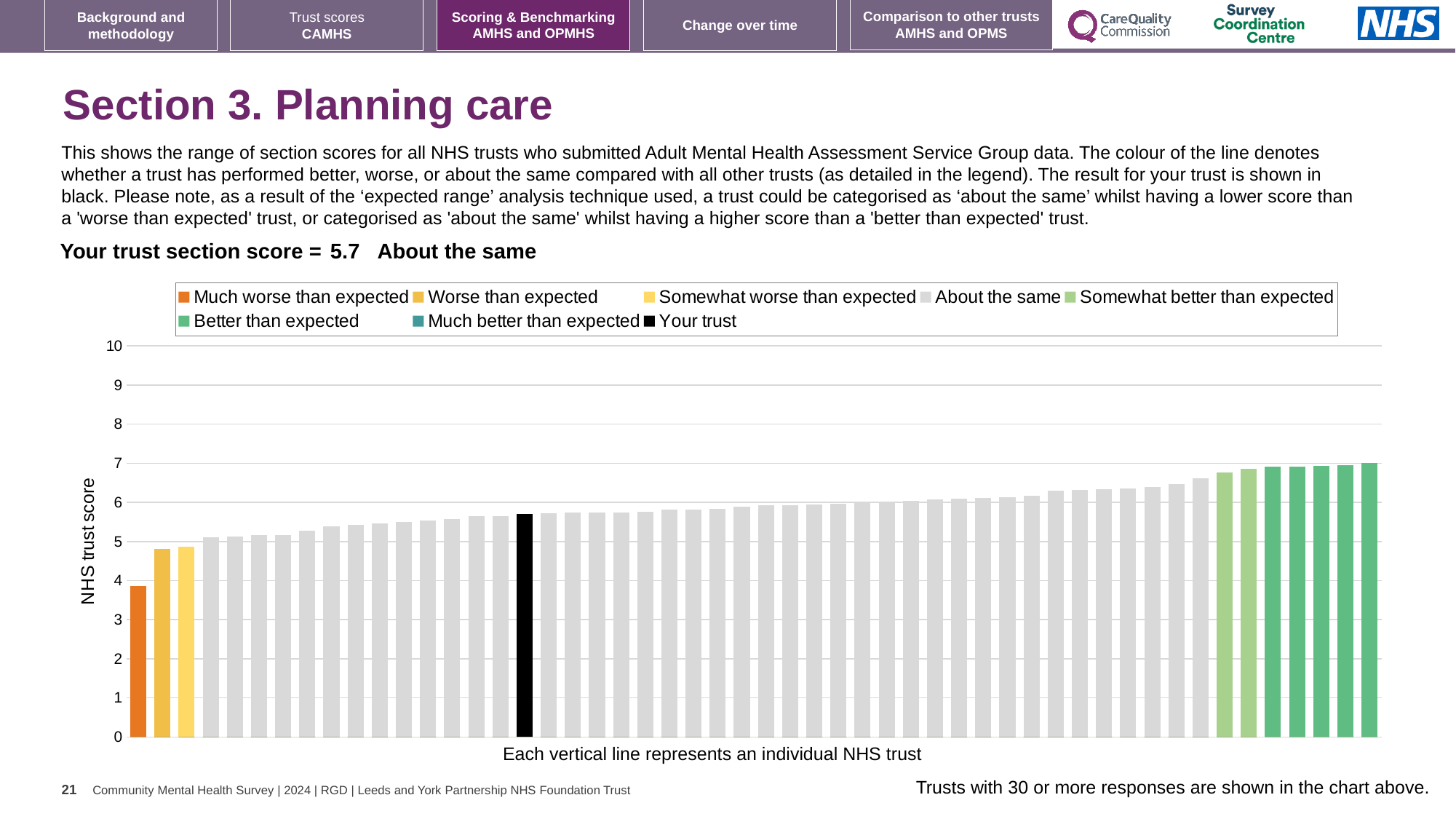
Which is larger: the value for your trust or the value for the orange 'Much worse than expected' bar? your trust Is the value for the lowest (orange) bar greater or less than 5? less What kind of chart is shown on the slide? bar chart Which category is your trust placed in for this section? About the same Is the value for the highest bar greater or less than 6? greater What is the label on the vertical axis of the chart? NHS trust score Do the bar values rise or fall from left to right along the x axis? rise How many bars are coloured as 'Much worse than expected'? 1 Is the value for your trust greater or less than 5? greater What is the section score for your trust shown on the slide? 5.7 How many entries does the chart legend list? 8 How many bars are coloured as 'Worse than expected'? 1